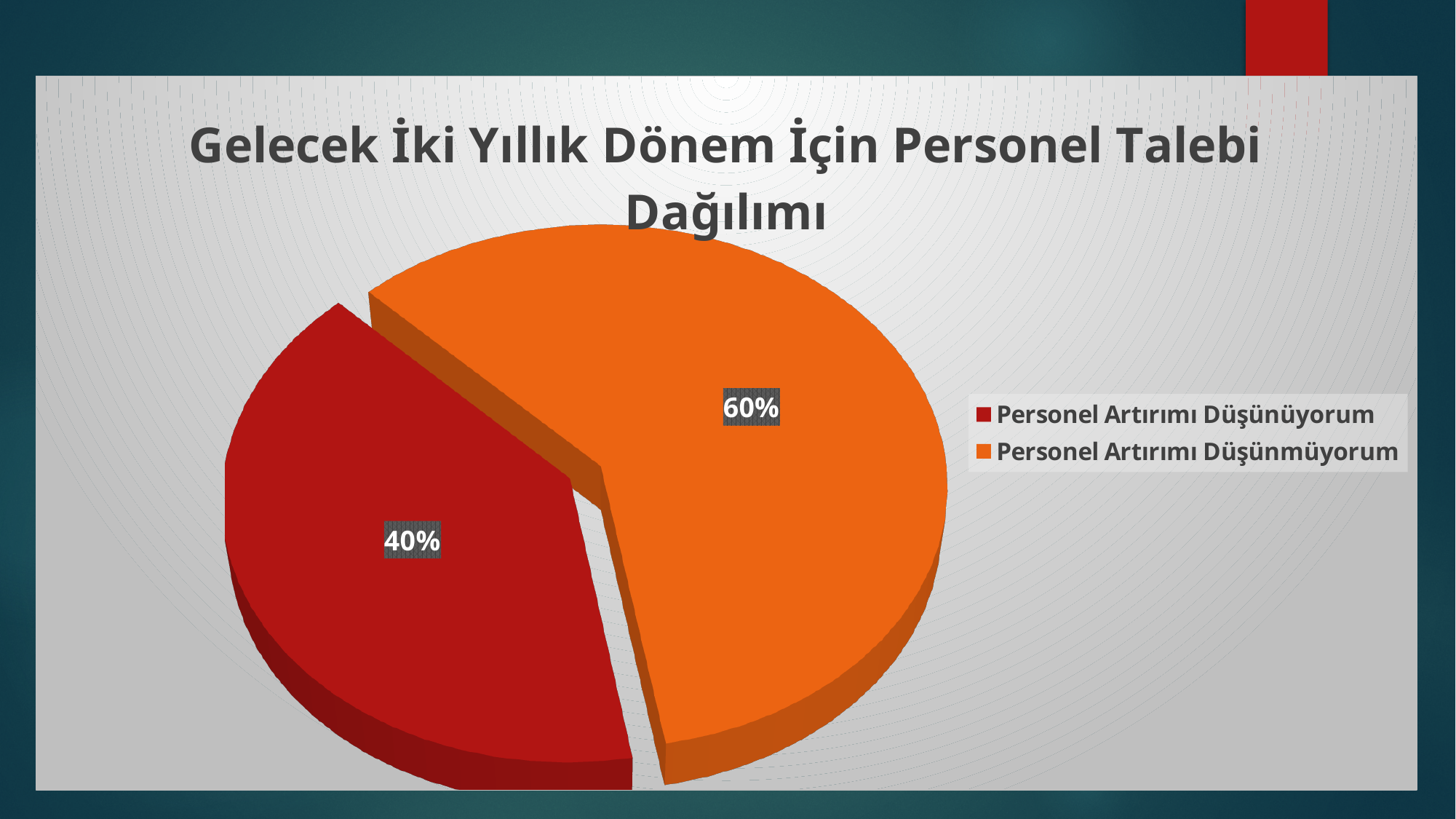
What is the difference in percentage points between the "Personel Artırımı Düşünmüyorum" slice and the "Personel Artırımı Düşünüyorum" slice? 20 percentage points Which is larger: the share for "Personel Artırımı Düşünüyorum" or the share for "Personel Artırımı Düşünmüyorum"? Personel Artırımı Düşünmüyorum How many slices does the pie chart have? 2 What percentage of the pie is labelled "Personel Artırımı Düşünmüyorum"? 60% What is the title of the chart? Gelecek İki Yıllık Dönem İçin Personel Talebi Dağılımı What percentage of the pie is labelled "Personel Artırımı Düşünüyorum"? 40% What share of the pie does the red slice represent? 40% Which category has the largest share of the pie? Personel Artırımı Düşünmüyorum What kind of chart is shown on the slide? Pie chart Which category has the smallest share of the pie? Personel Artırımı Düşünüyorum How many entries does the legend list? 2 What colour is the slice for "Personel Artırımı Düşünmüyorum"? Orange